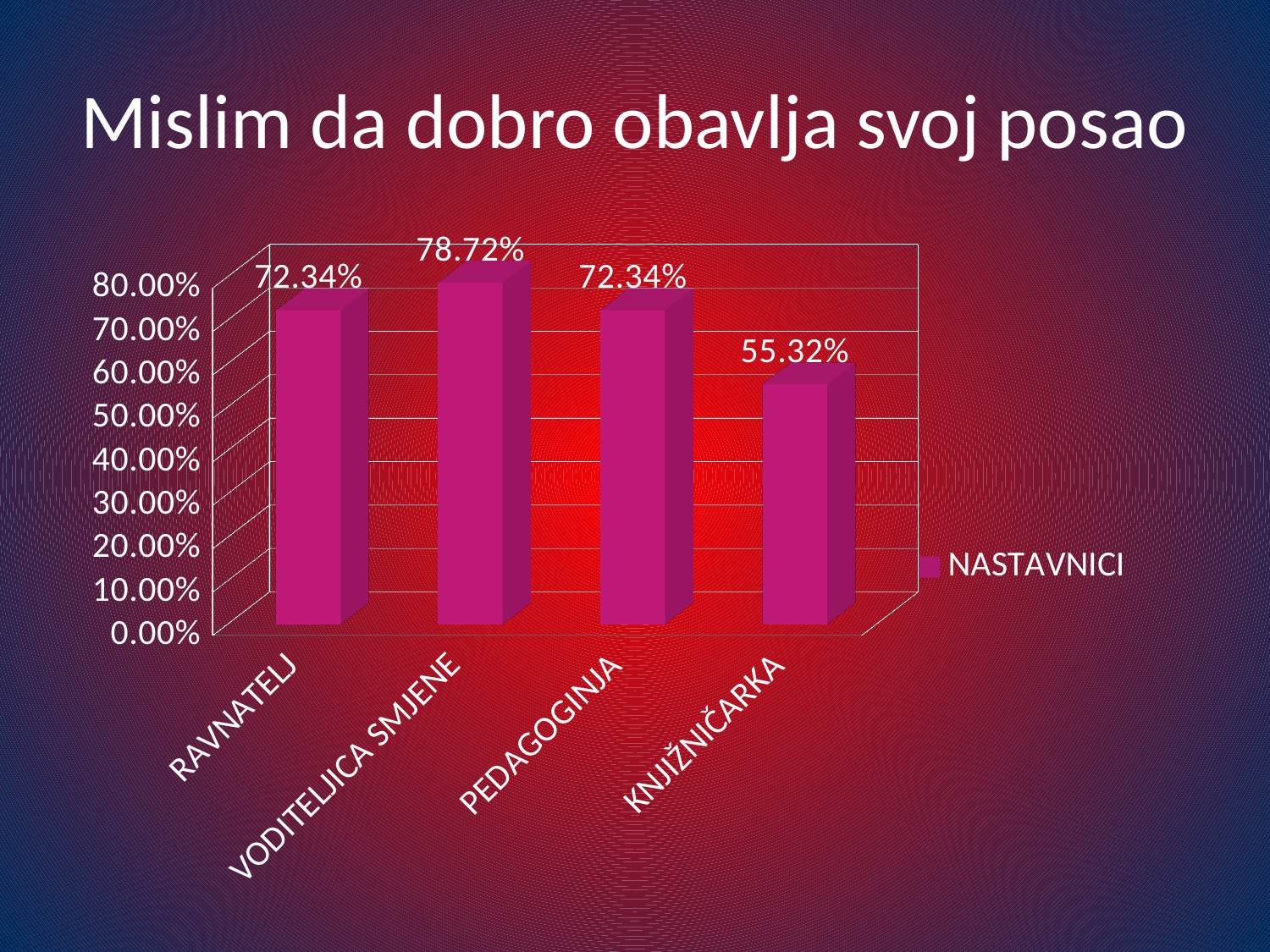
Is the value for KNJIŽNIČARKA greater or less than 60.00%? less What is the value for PEDAGOGINJA? 72.34% What series name does the legend list? NASTAVNICI What is the value for RAVNATELJ? 72.34% How many categories are shown on the x axis? 4 Which category has the highest value? VODITELJICA SMJENE Which category has the lowest value? KNJIŽNIČARKA Which is larger, the value for VODITELJICA SMJENE or the value for PEDAGOGINJA? VODITELJICA SMJENE What kind of chart is shown on the slide? bar chart What is the difference between the values for VODITELJICA SMJENE and KNJIŽNIČARKA? 23.40% What is the value for VODITELJICA SMJENE? 78.72% What is the value for KNJIŽNIČARKA? 55.32%